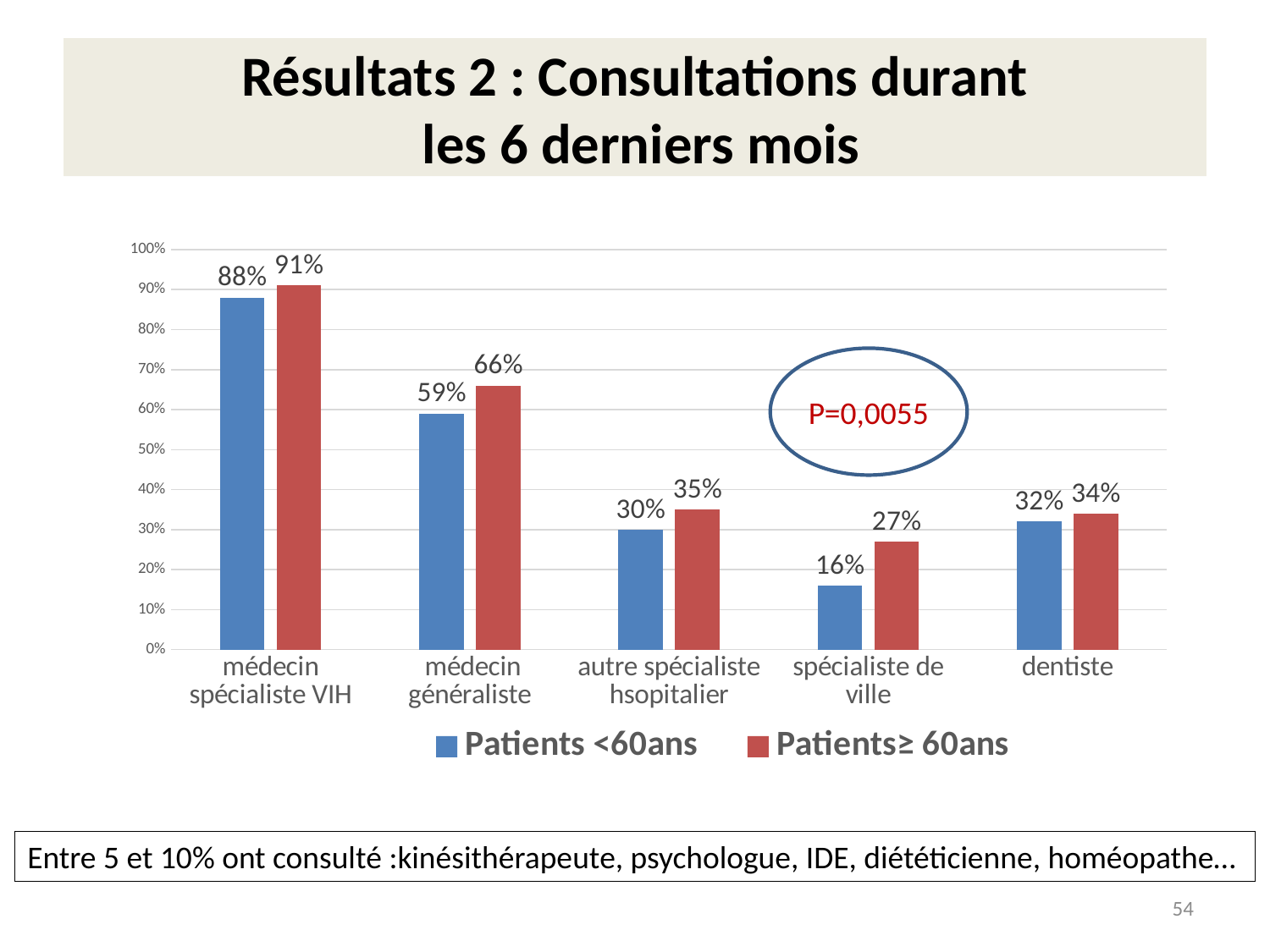
What is the value for Patients <60ans for médecin spécialiste VIH? 88% Which category has the lowest value for Patients <60ans? spécialiste de ville What is the difference between Patients≥ 60ans and Patients <60ans for spécialiste de ville? 11% Which category has the highest value for Patients≥ 60ans? médecin spécialiste VIH Which is larger for autre spécialiste hsopitalier: Patients <60ans or Patients≥ 60ans? Patients≥ 60ans How many series does the legend list? 2 How many categories are shown on the x axis? 5 What is the value for Patients <60ans for dentiste? 32% What is the difference between Patients≥ 60ans and Patients <60ans for médecin généraliste? 7% What P value is shown in the circle on the chart? P=0,0055 What kind of chart is shown on the slide? bar chart What is the value for Patients≥ 60ans for spécialiste de ville? 27%